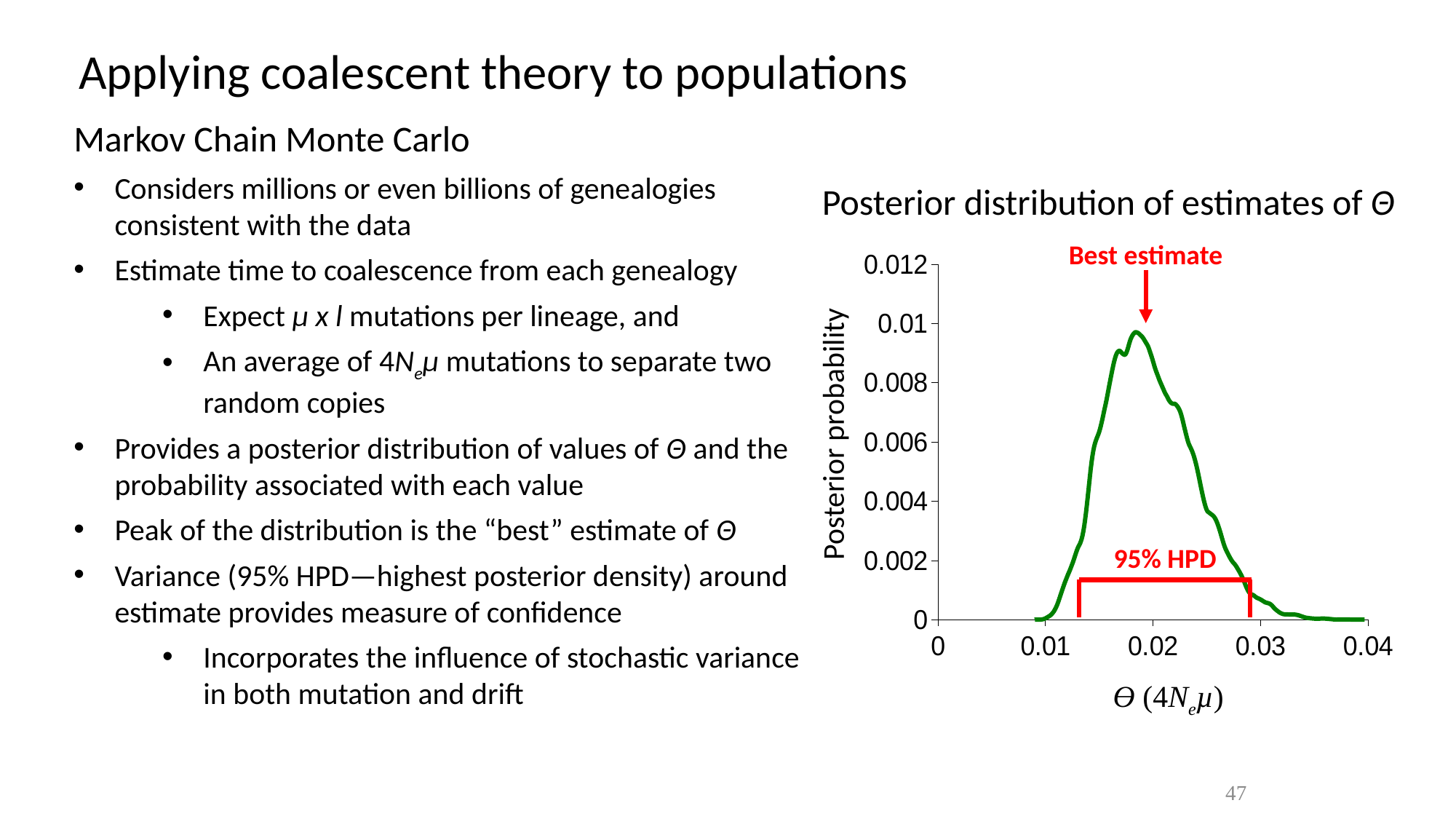
What kind of chart is shown on the slide? Line chart What is the label of the y axis of the chart? Posterior probability Is the peak value of the curve greater or less than 0.012? less Is the peak value of the curve greater or less than 0.008? greater What is the title of the chart on the slide? Posterior distribution of estimates of Θ Which is larger, the posterior probability at Θ = 0.01 or at Θ = 0.02? Θ = 0.02 Is the posterior probability at Θ = 0.01 greater or less than 0.002? less Which is larger, the posterior probability at Θ = 0.02 or at Θ = 0.03? Θ = 0.02 What is the highest value shown on the y axis of the chart? 0.012 How does the curve behave as Θ increases from 0.01 to 0.04? It rises to a peak near 0.02 and then falls